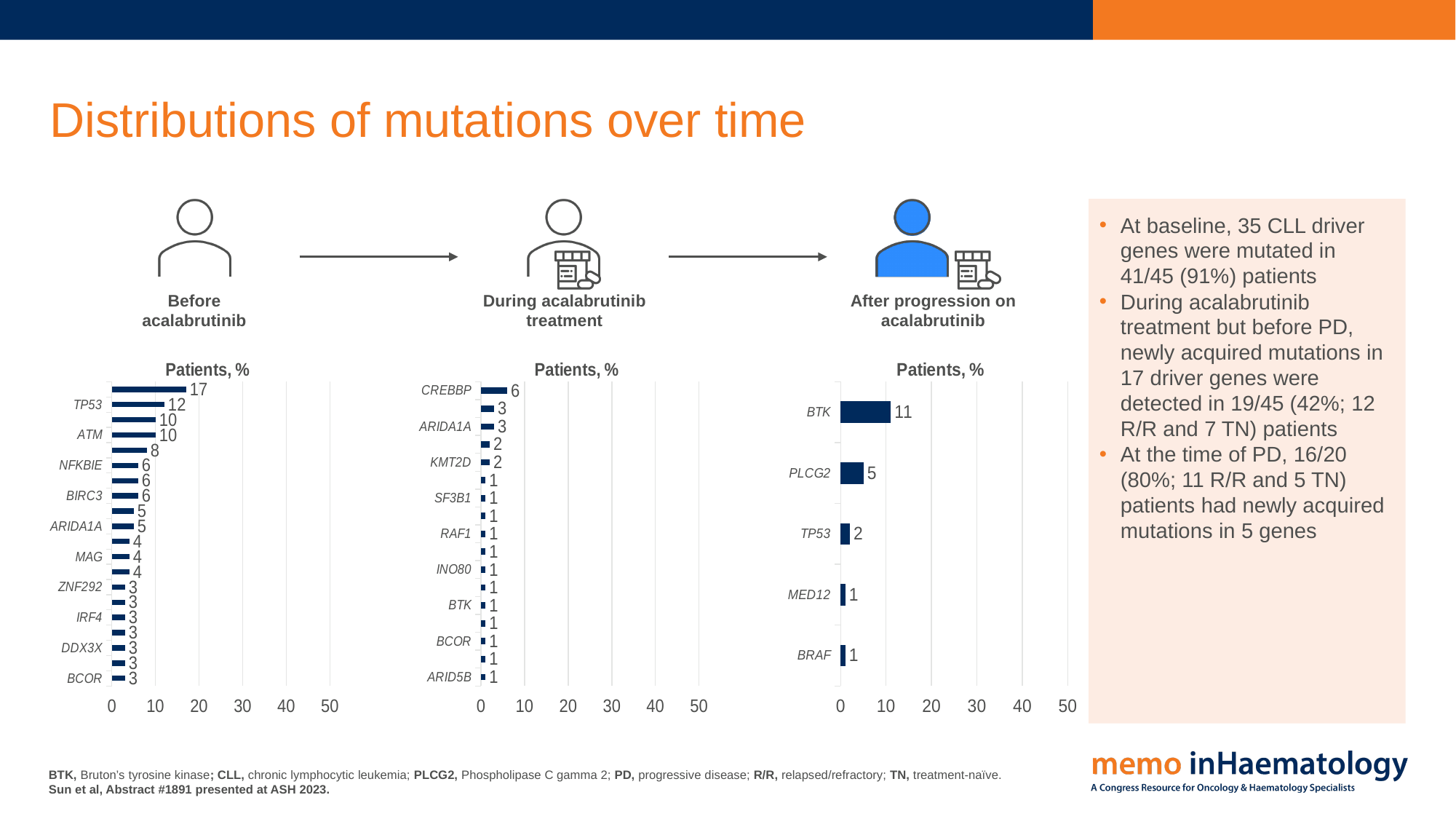
In the 'During acalabrutinib treatment' chart, is the value for CREBBP greater or less than 10? less In the 'Before acalabrutinib' chart, what is the value for TP53? 12 In the 'After progression on acalabrutinib' chart, what is the value for PLCG2? 5 What type of chart is used in the 'After progression on acalabrutinib' panel? Bar chart In the 'During acalabrutinib treatment' chart, what is the value for KMT2D? 2 In the 'During acalabrutinib treatment' chart, what is the value for CREBBP? 6 In the 'After progression on acalabrutinib' chart, what is the difference between the values for BTK and PLCG2? 6 In the 'Before acalabrutinib' chart, which is larger, the value for NFKBIE or the value for ZNF292? NFKBIE In the 'After progression on acalabrutinib' chart, what is the value for BTK? 11 In the 'Before acalabrutinib' chart, what is the value for ATM? 10 In the 'After progression on acalabrutinib' chart, how many genes are plotted? 5 In the 'After progression on acalabrutinib' chart, which gene has the highest value? BTK